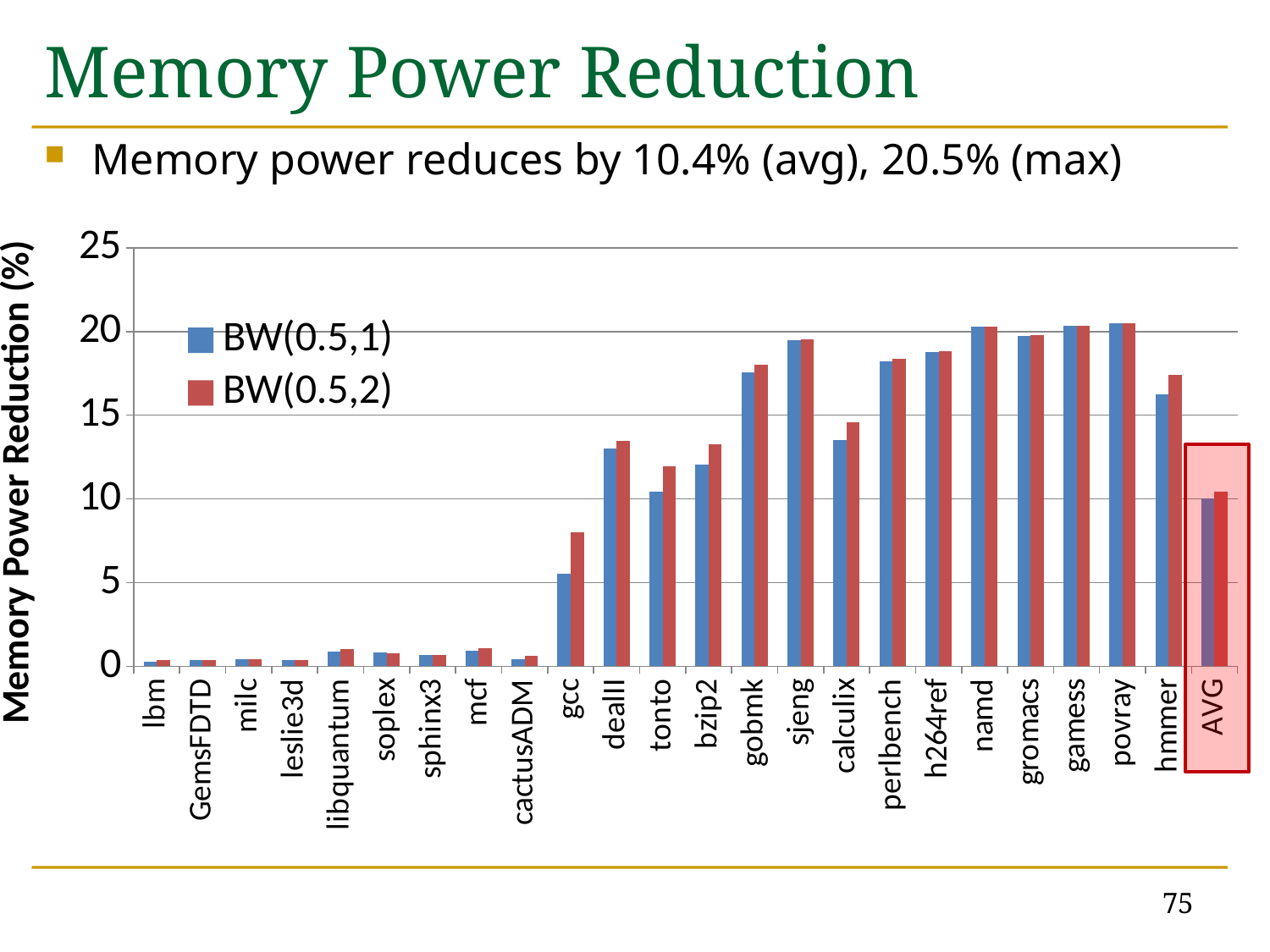
How many series does the legend list? 2 Which benchmark has the highest memory power reduction? povray Do the memory power reduction values generally rise or fall from left to right across the benchmarks? rise Which has the larger memory power reduction, gcc or dealII? dealII Is the BW(0.5,1) value for calculix greater or less than 15? less Is the BW(0.5,1) value for hmmer greater or less than 15? greater For gcc, which series has the larger value, BW(0.5,1) or BW(0.5,2)? BW(0.5,2) Is the BW(0.5,2) value for gcc greater or less than 5? greater What are the two series named in the legend? BW(0.5,1) and BW(0.5,2) How many categories are shown along the x axis, including AVG? 24 What kind of chart is shown on the slide? bar chart